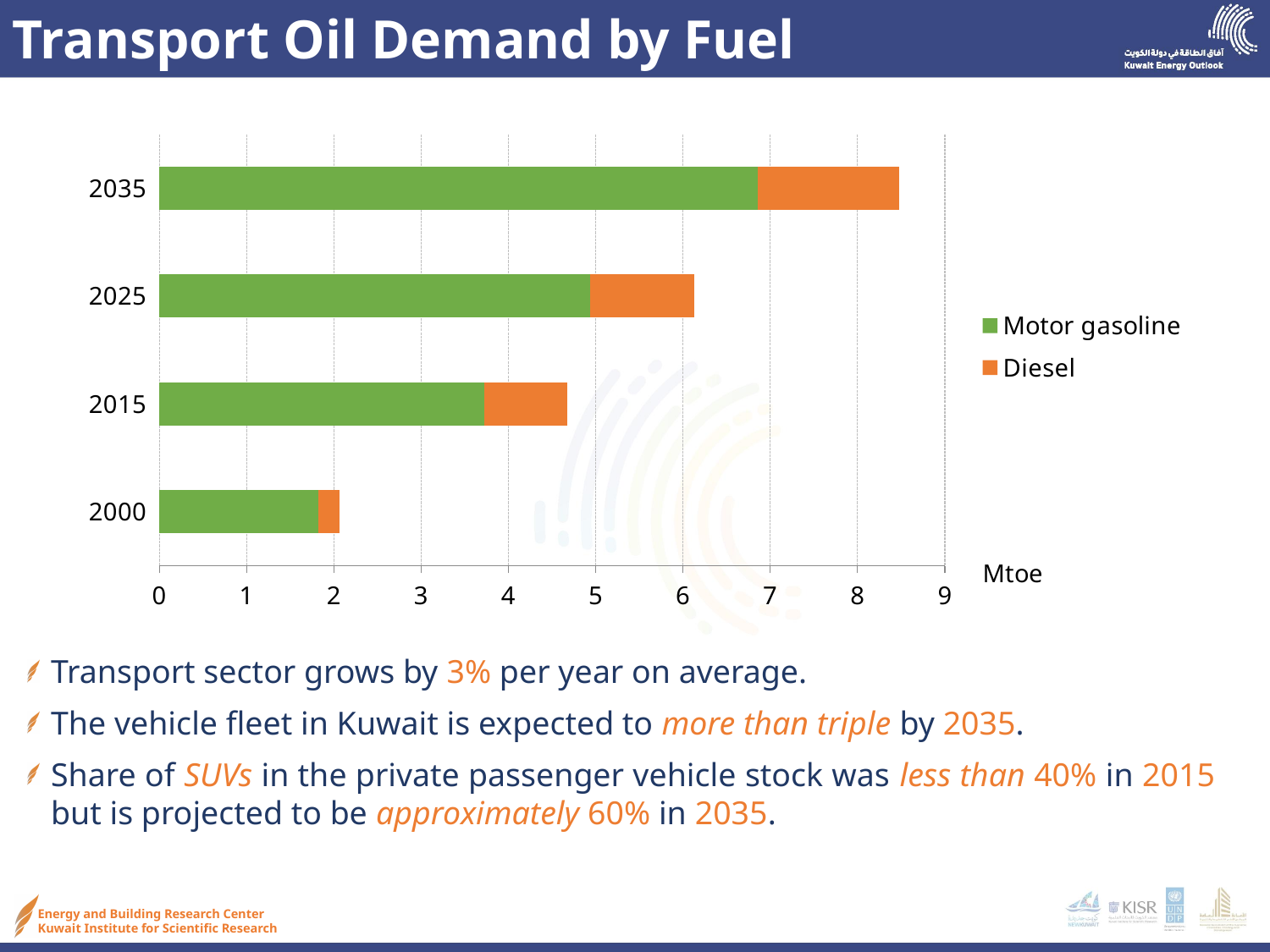
How many years (categories) are plotted on the chart? 4 How many series does the legend list? 2 Does total transport oil demand rise or fall from 2000 to 2035? rise Which is larger in 2035, the Motor gasoline segment or the Diesel segment? Motor gasoline What kind of chart is shown on the slide? stacked bar chart Is the total transport oil demand for 2035 greater or less than 8 Mtoe? greater Is the total transport oil demand for 2000 greater or less than 3 Mtoe? less Which year has the highest total transport oil demand? 2035 Is the Motor gasoline value for 2015 greater or less than 3 Mtoe? greater Which year has the lowest total transport oil demand? 2000 What unit is shown on the horizontal axis of the chart? Mtoe